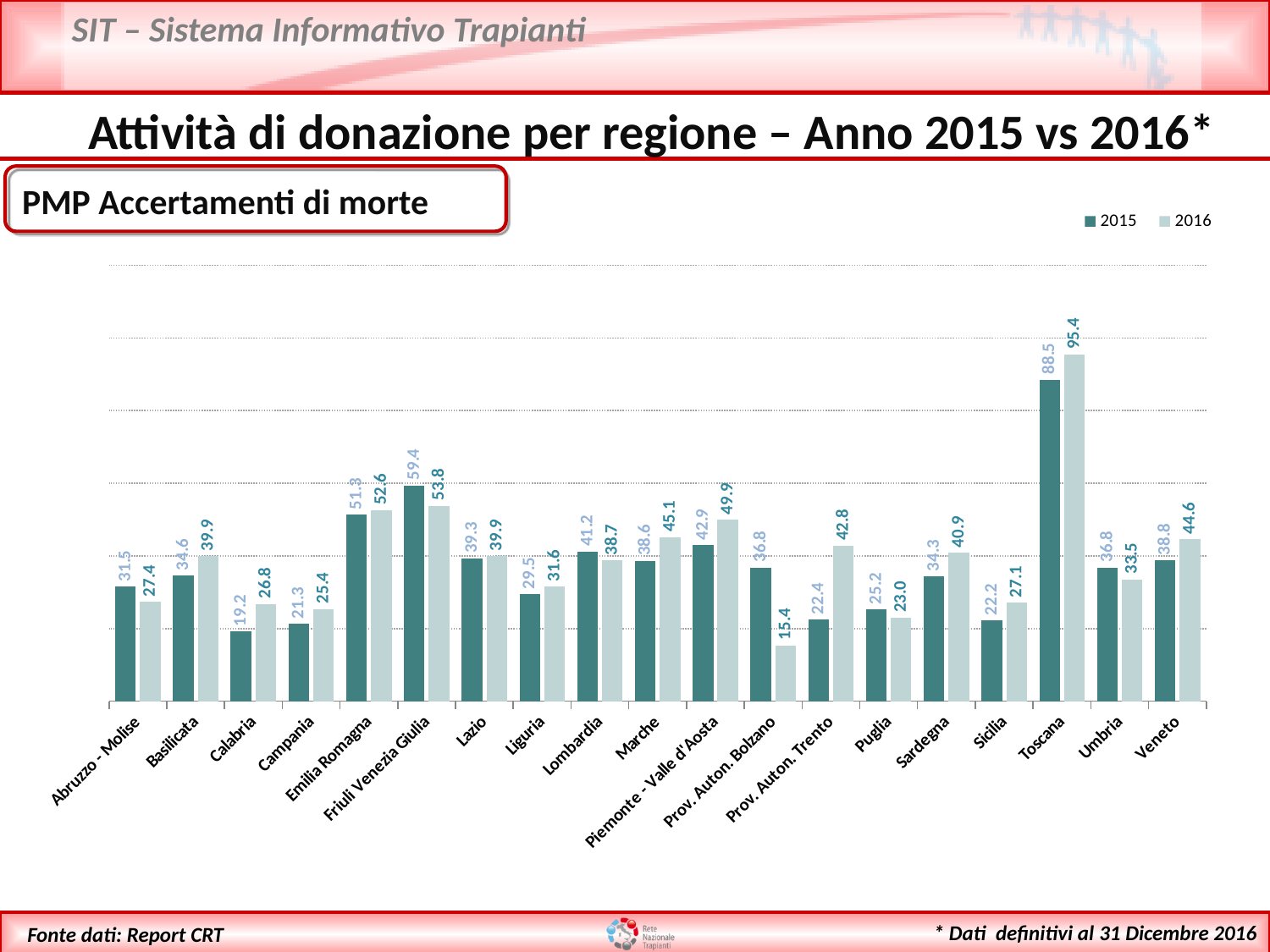
How many series does the legend list? 2 What is the 2015 value for Prov. Auton. Bolzano? 36.8 Which region has the highest 2015 value? Toscana Which is larger for Marche, the 2015 value or the 2016 value? 2016 What is the difference between the 2016 and 2015 values for Prov. Auton. Trento? 20.4 Which region has the lowest 2016 value? Prov. Auton. Bolzano Which is larger for Friuli Venezia Giulia, the 2015 value or the 2016 value? 2015 What kind of chart is shown on the slide? Bar chart How many regions are shown on the x axis? 19 What is the 2016 value for Toscana? 95.4 What is the 2016 value for Calabria? 26.8 Which region has the lowest 2015 value? Calabria